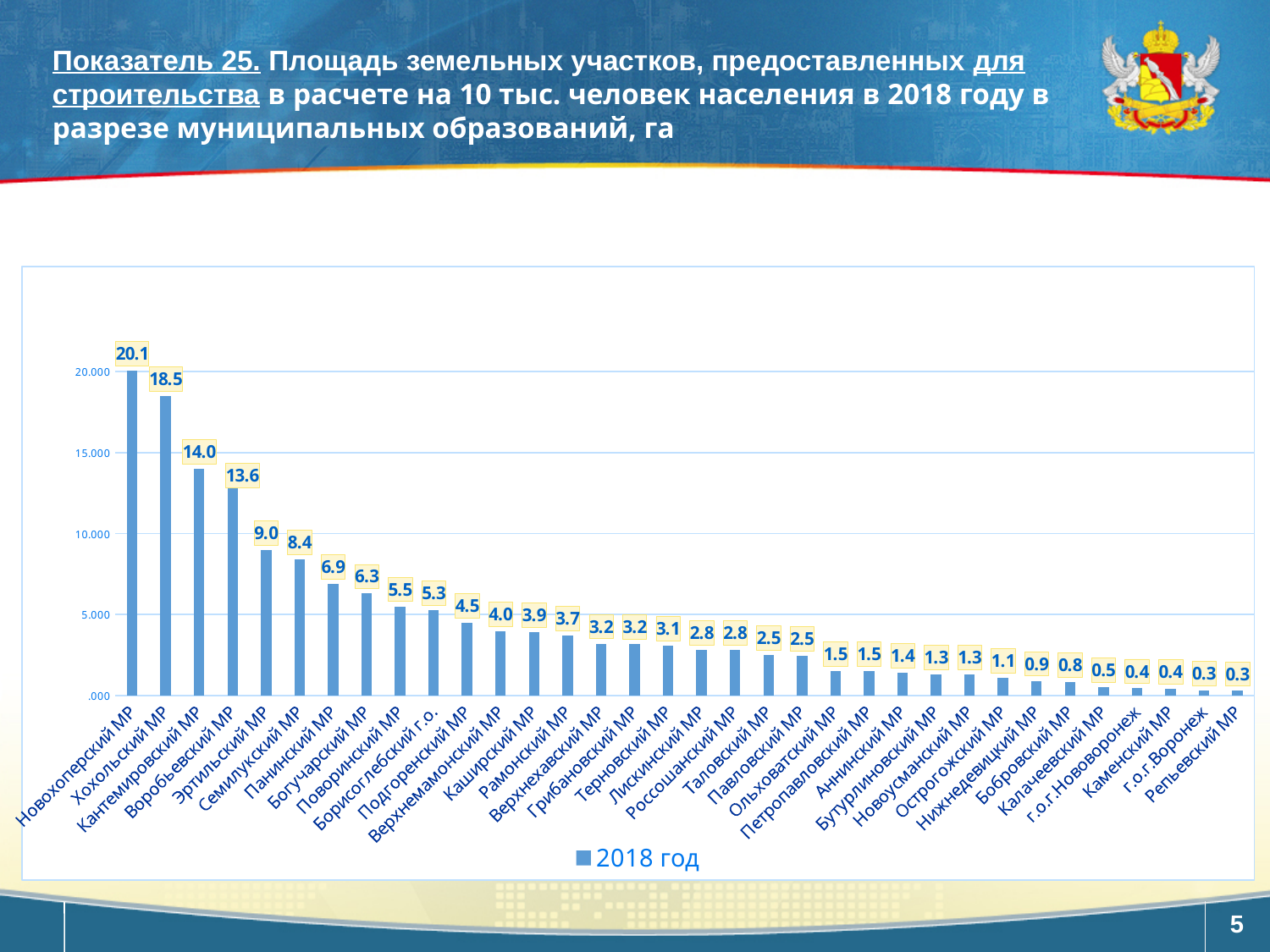
How many municipalities are shown on the chart? 34 What is the value for Борисоглебский г.о.? 5.3 Is the value for Воробьевский МР greater or less than 15.000? less What series does the legend list? 2018 год What is the difference between the values for Новохоперский МР and Хохольский МР? 1.6 What is the value for Новохоперский МР? 20.1 Which is larger, the value for Панинский МР or the value for Богучарский МР? Панинский МР What is the difference between the values for Кантемировский МР and Эртильский МР? 5.0 Which municipality has the highest value? Новохоперский МР What is the value for Семилукский МР? 8.4 What is the value for г.о.г.Воронеж? 0.3 What kind of chart is shown on the slide? bar chart